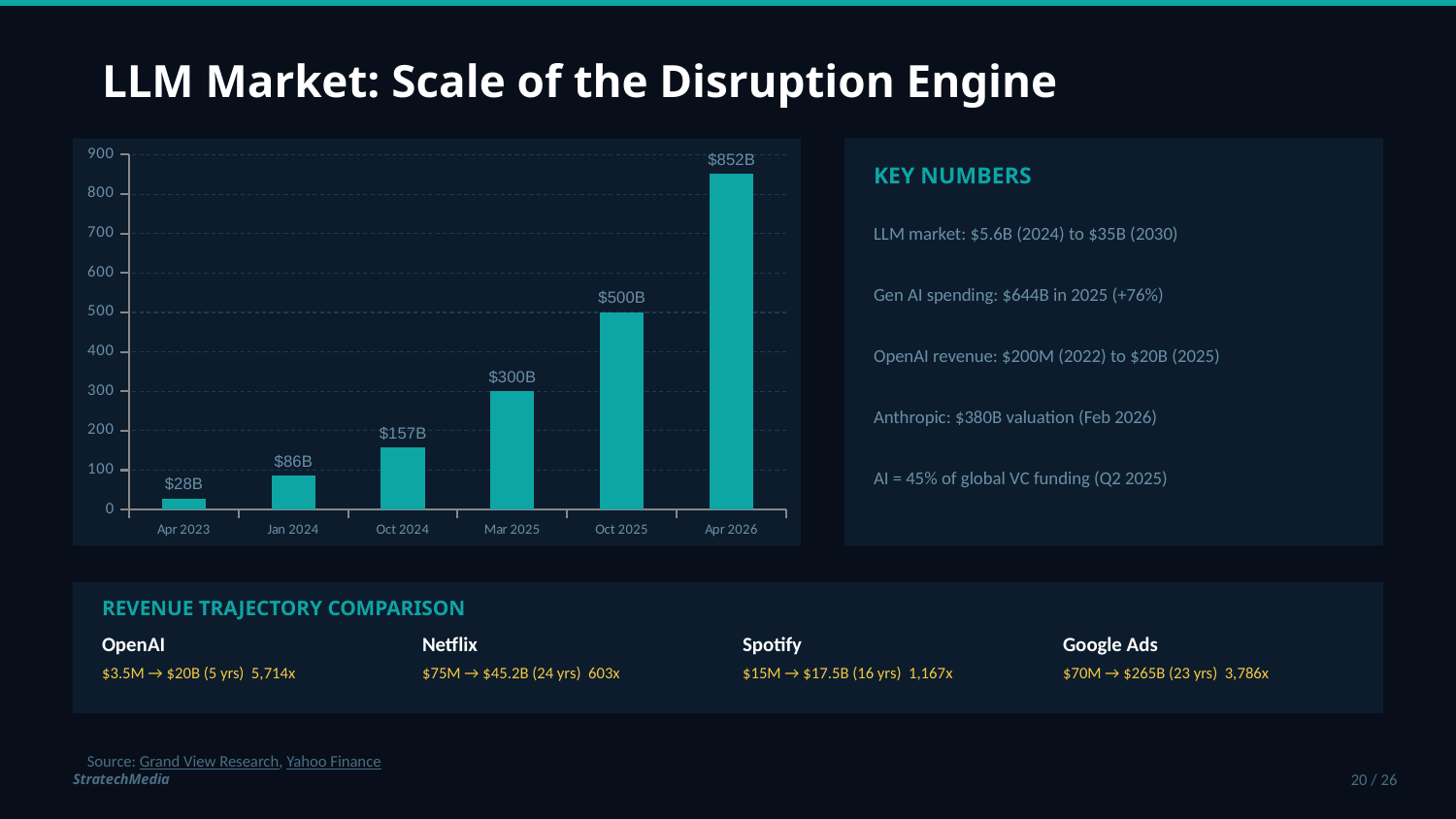
Which is larger, the value for Mar 2025 or the value for Oct 2024? Mar 2025 What is the value shown for Apr 2026? $852B How many bars are shown in the chart? 6 What is the difference between the values for Oct 2025 and Mar 2025? $200B Is the value for Oct 2025 greater or less than 400? greater Which date has the lowest value? Apr 2023 What is the difference between the values for Jan 2024 and Apr 2023? $58B What kind of chart is shown on the slide? bar chart Do the values rise or fall from Apr 2023 to Apr 2026? rise What is the value shown for Apr 2023? $28B What is the value shown for Oct 2024? $157B Which date has the highest value? Apr 2026